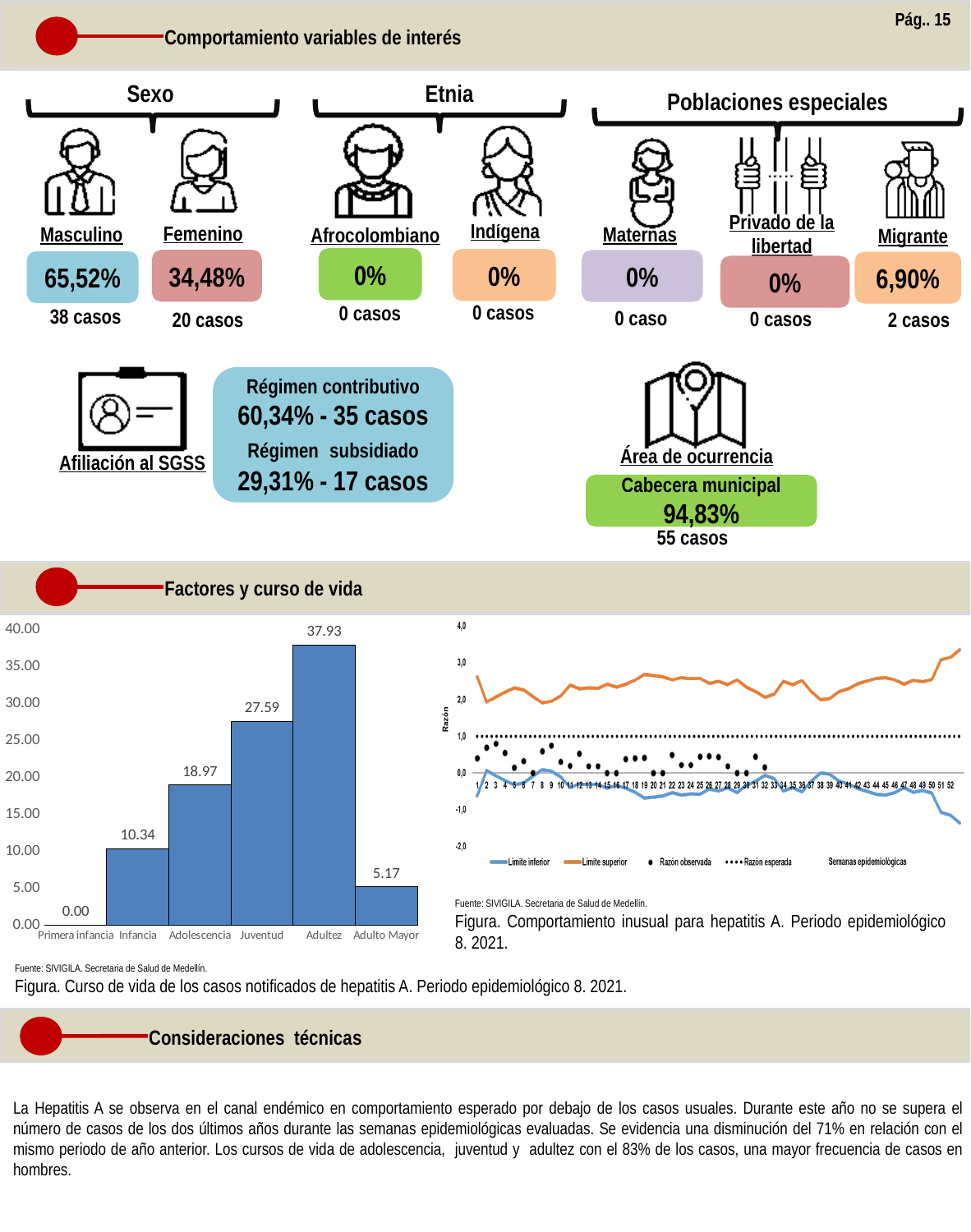
In the 'Curso de vida' bar chart, which category has the lowest value? Primera infancia How many categories are shown in the 'Curso de vida' bar chart? 6 In the 'Curso de vida' bar chart, what is the value for Infancia? 10.34 In the 'Curso de vida' bar chart, what is the value for Adultez? 37.93 In the 'Comportamiento inusual' chart on the right, is the value of Límite superior at week 1 greater or less than 2,0? greater What kind of chart is the 'Curso de vida' chart on the left? Bar chart How many series does the legend of the 'Comportamiento inusual' chart on the right list? 4 In the 'Curso de vida' bar chart, which is larger, the value for Adolescencia or the value for Adulto Mayor? Adolescencia What is the y-axis label of the 'Comportamiento inusual' chart on the right? Razón In the 'Curso de vida' bar chart, what is the difference between the values for Adultez and Juventud? 10.34 In the 'Curso de vida' bar chart, what is the value for Adulto Mayor? 5.17 In the 'Curso de vida' bar chart, which category has the highest value? Adultez